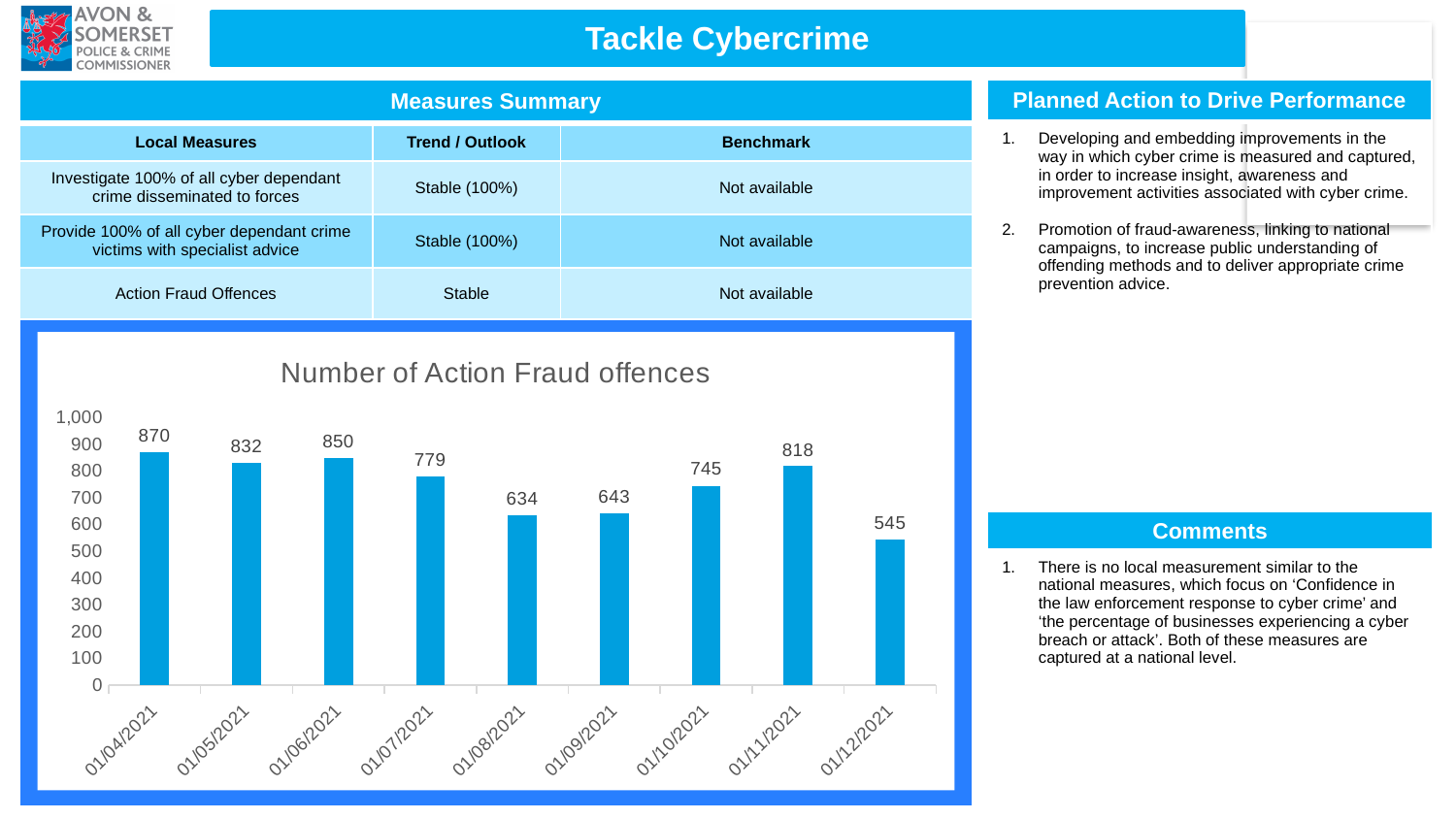
What type of chart is used to show the Number of Action Fraud offences? Bar chart Which month has the lowest number of Action Fraud offences? 01/12/2021 What is the difference between the number of Action Fraud offences in 01/06/2021 and 01/07/2021? 71 How many months are shown in the Number of Action Fraud offences chart? 9 Which month has the highest number of Action Fraud offences? 01/04/2021 What is the title of the chart on the slide? Number of Action Fraud offences Which month has more Action Fraud offences, 01/05/2021 or 01/10/2021? 01/05/2021 What is the number of Action Fraud offences for 01/11/2021? 818 What is the number of Action Fraud offences for 01/08/2021? 634 What is the number of Action Fraud offences for 01/04/2021? 870 Is the number of Action Fraud offences for 01/09/2021 greater or less than 700? less What is the difference between the number of Action Fraud offences in 01/04/2021 and 01/12/2021? 325